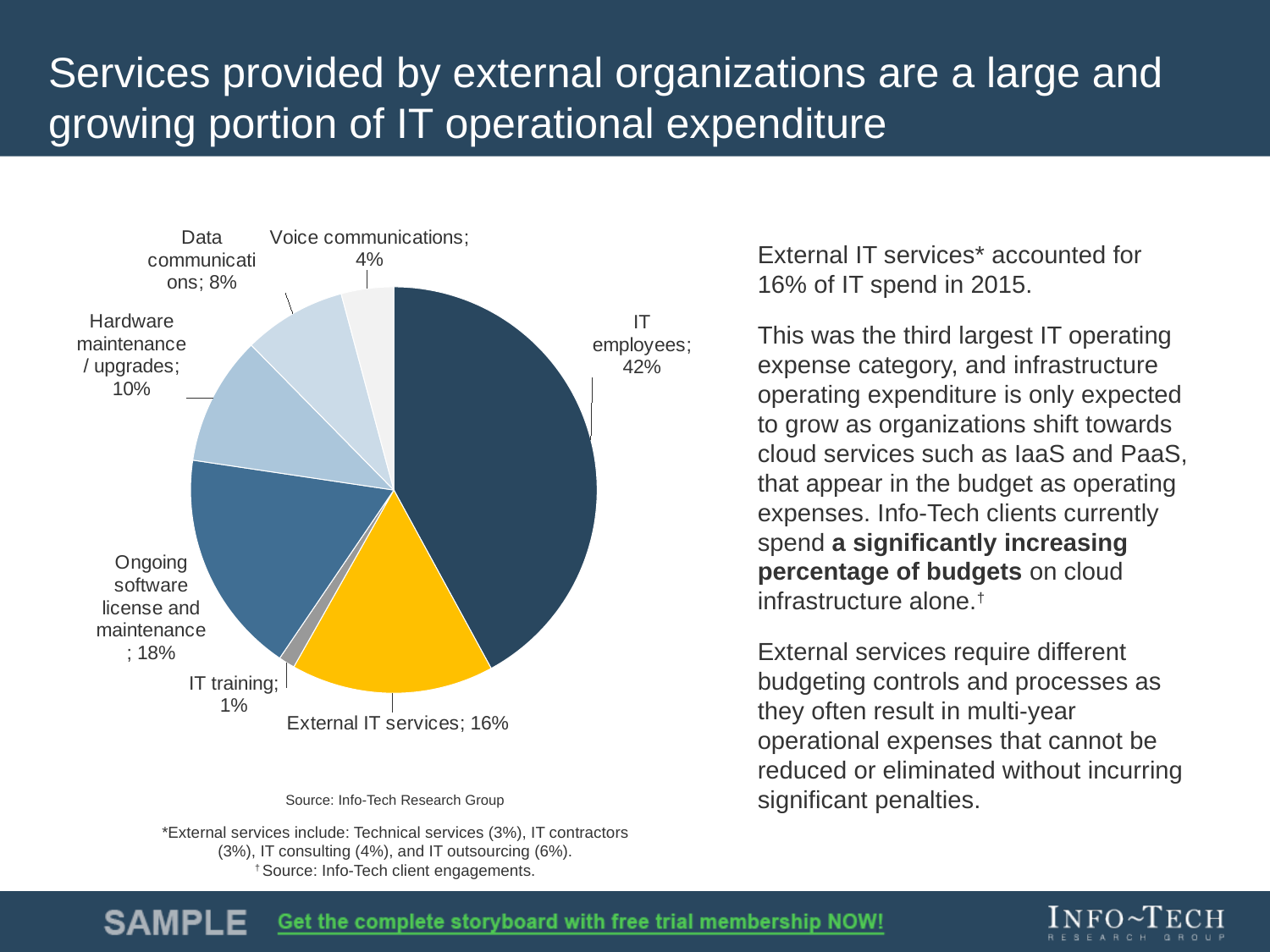
What kind of chart is shown on the slide? Pie chart What percentage does the pie chart show for External IT services? 16% What percentage does the pie chart show for Ongoing software license and maintenance? 18% Which category has the smallest slice of the pie chart? IT training What percentage does the pie chart show for Voice communications? 4% Which is larger in the pie chart, Data communications or Hardware maintenance / upgrades? Hardware maintenance / upgrades Which category has the largest slice of the pie chart? IT employees What share of IT spend does the pie chart show for IT employees? 42% What colour is the External IT services slice in the pie chart? Yellow What is the difference in percentage points between IT employees and Ongoing software license and maintenance? 24 What percentage does the pie chart show for Hardware maintenance / upgrades? 10%